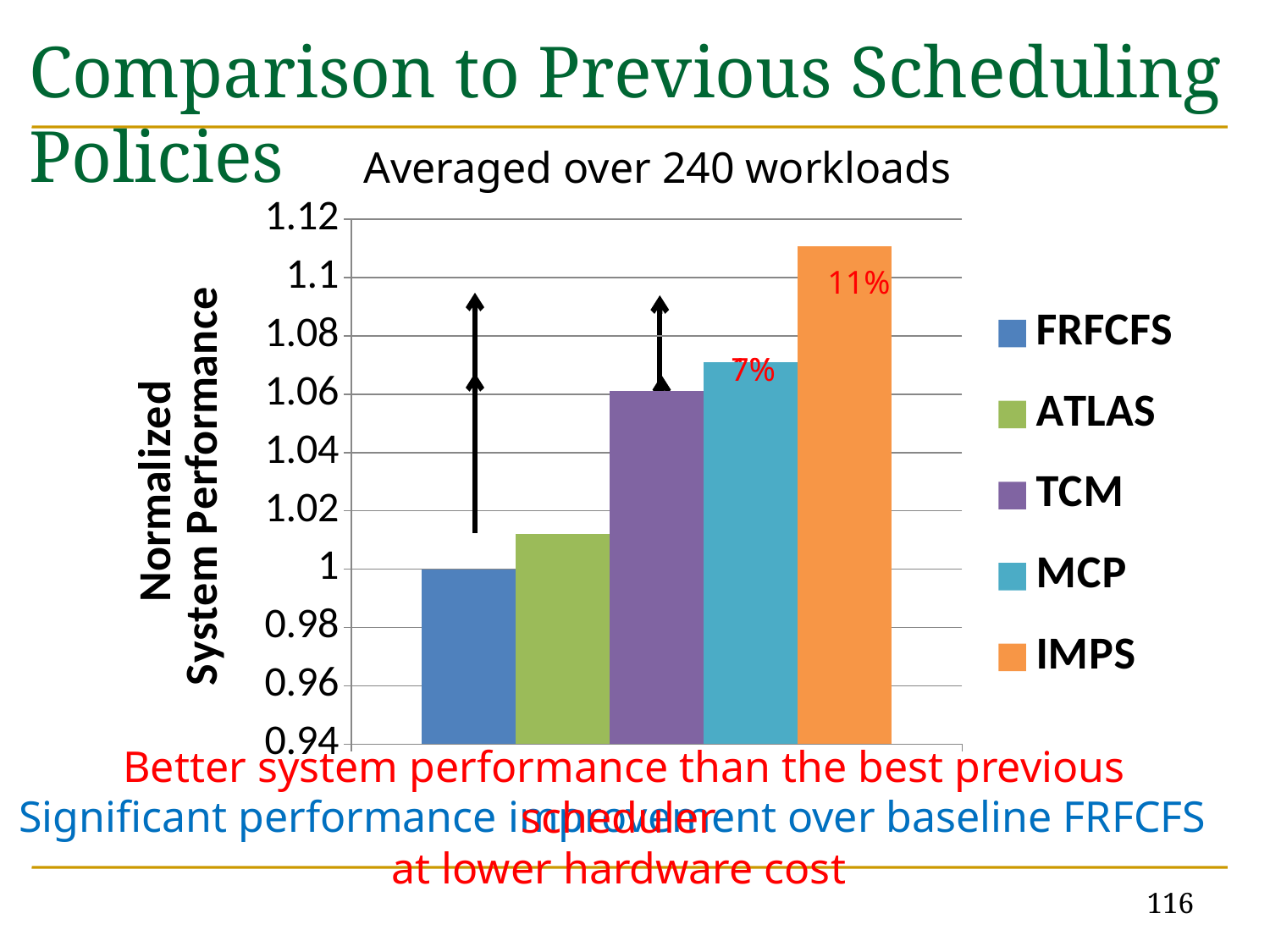
How many series does the legend list? 5 Is the normalized system performance for TCM greater or less than 1.04? greater Which scheduling policy has the highest normalized system performance? IMPS Which scheduling policy has the lowest normalized system performance? FRFCFS Is the normalized system performance for IMPS greater or less than 1.1? greater What is the title shown above the chart? Averaged over 240 workloads What colour is the IMPS bar? orange What kind of chart is shown on the slide? bar chart Is the normalized system performance for ATLAS greater or less than 1.02? less Do the bars rise or fall from left to right across the chart? rise What is the normalized system performance of FRFCFS? 1 Which has a higher normalized system performance, ATLAS or TCM? TCM